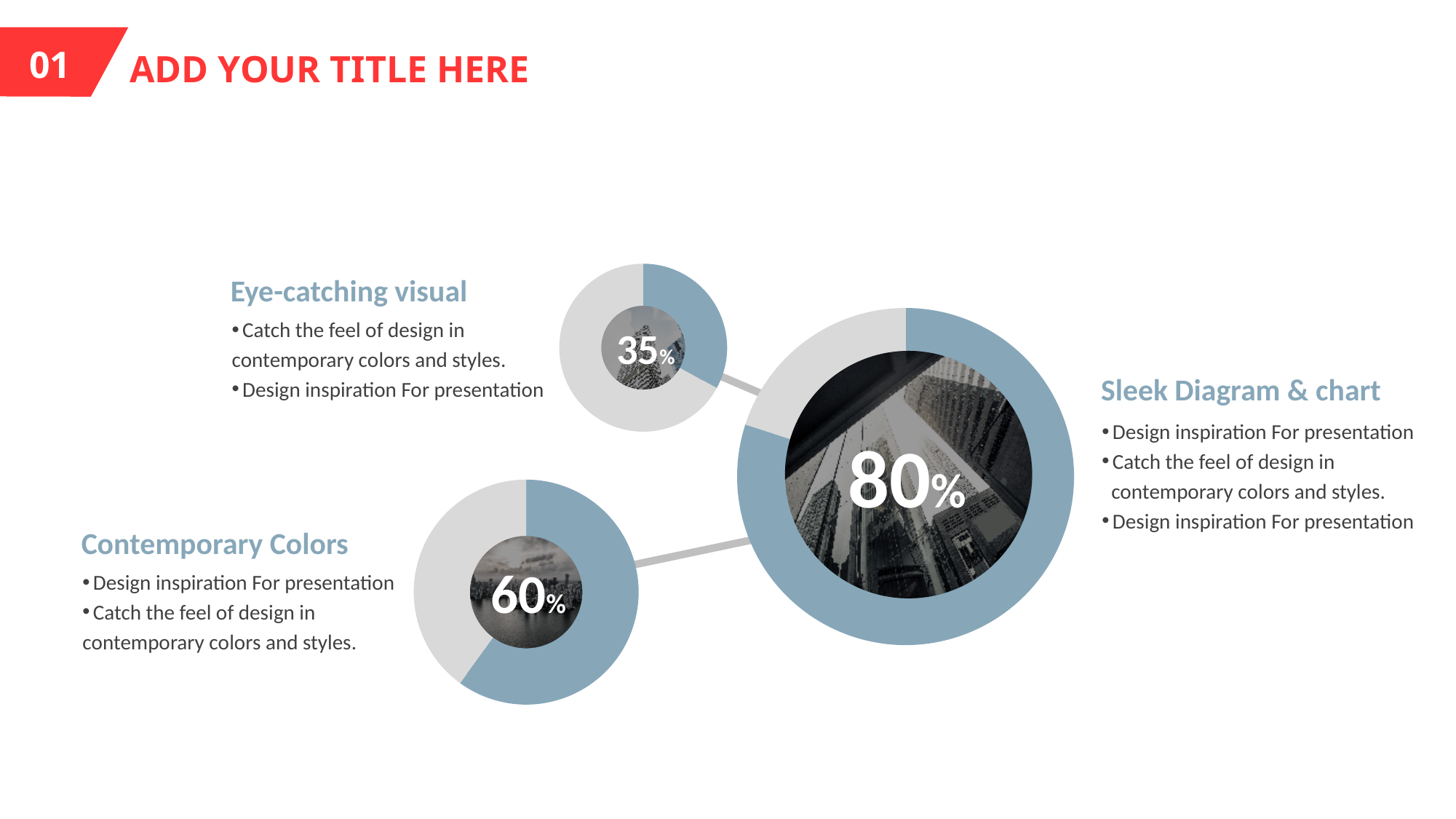
What percentage is shown in the chart next to "Contemporary Colors"? 60% How many percentage charts are shown on the slide? 3 What percentage is shown in the chart next to "Sleek Diagram & chart"? 80% Which of the three charts shows the lowest percentage? Eye-catching visual (35%) What is the difference between the percentage for "Sleek Diagram & chart" and the percentage for "Eye-catching visual"? 45% Which is larger, the percentage for "Contemporary Colors" or the percentage for "Eye-catching visual"? Contemporary Colors Is the percentage shown in the "Contemporary Colors" chart greater or less than 50%? greater What kind of chart is used to display the percentages on the slide? Donut (ring) chart What is the difference between the percentage for "Contemporary Colors" and the percentage for "Eye-catching visual"? 25% What colour is the filled portion of each ring chart? Blue-grey Which of the three charts shows the highest percentage? Sleek Diagram & chart (80%) What percentage is shown in the chart next to "Eye-catching visual"? 35%